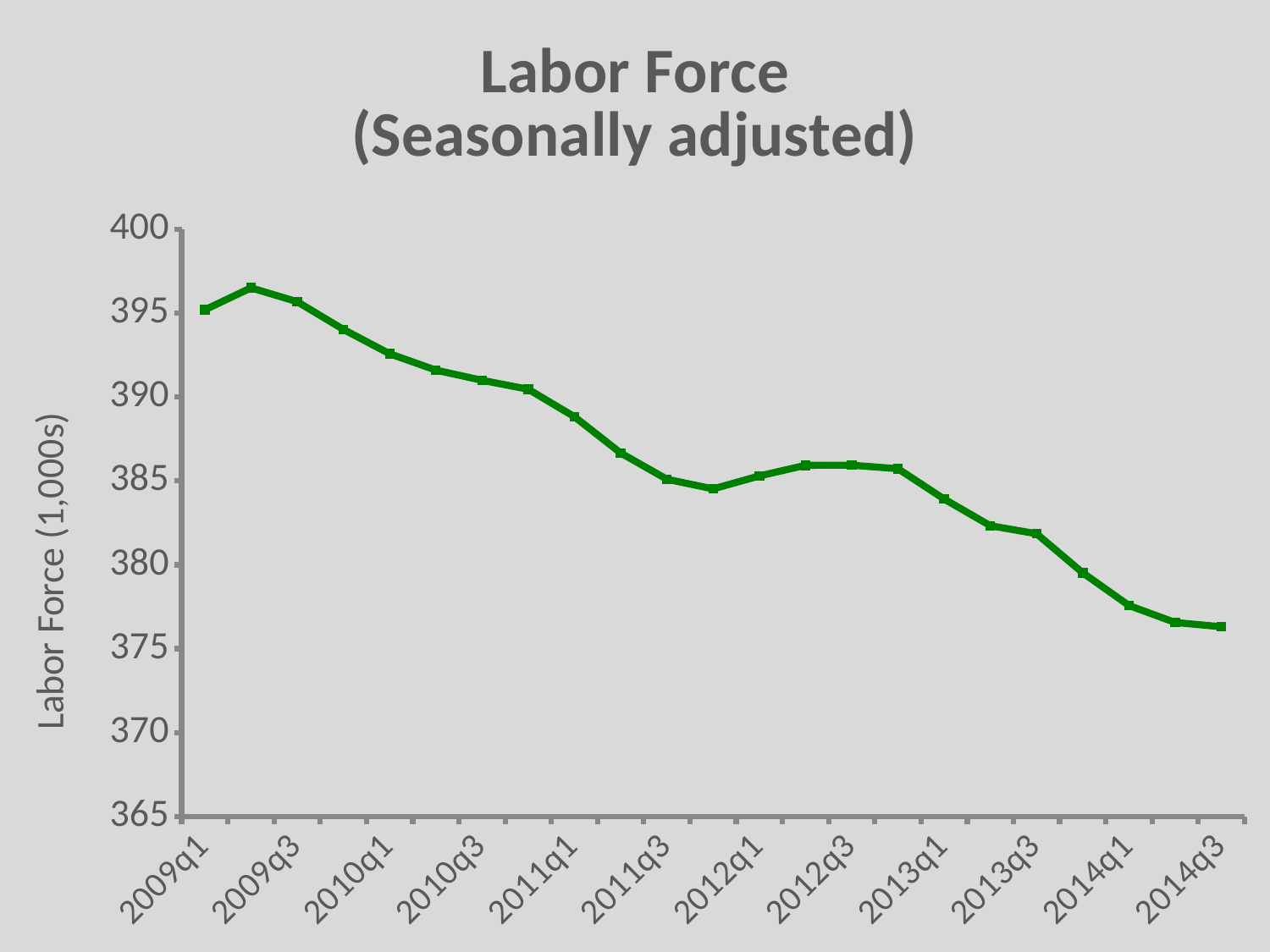
Is the value for 2013q3 greater or less than 385? less Is the value for 2010q1 greater or less than 390? greater Which is larger, the value for 2009q1 or the value for 2014q3? 2009q1 Is the value for 2014q3 greater or less than 380? less What is the title of the chart? Labor Force (Seasonally adjusted) What is the label on the vertical axis? Labor Force (1,000s) Which labeled quarter has the lowest value on the chart? 2014q3 What kind of chart is shown on the slide? line chart Overall, do the values rise or fall from 2009q1 to 2014q3? fall How many quarter labels are shown on the x axis? 12